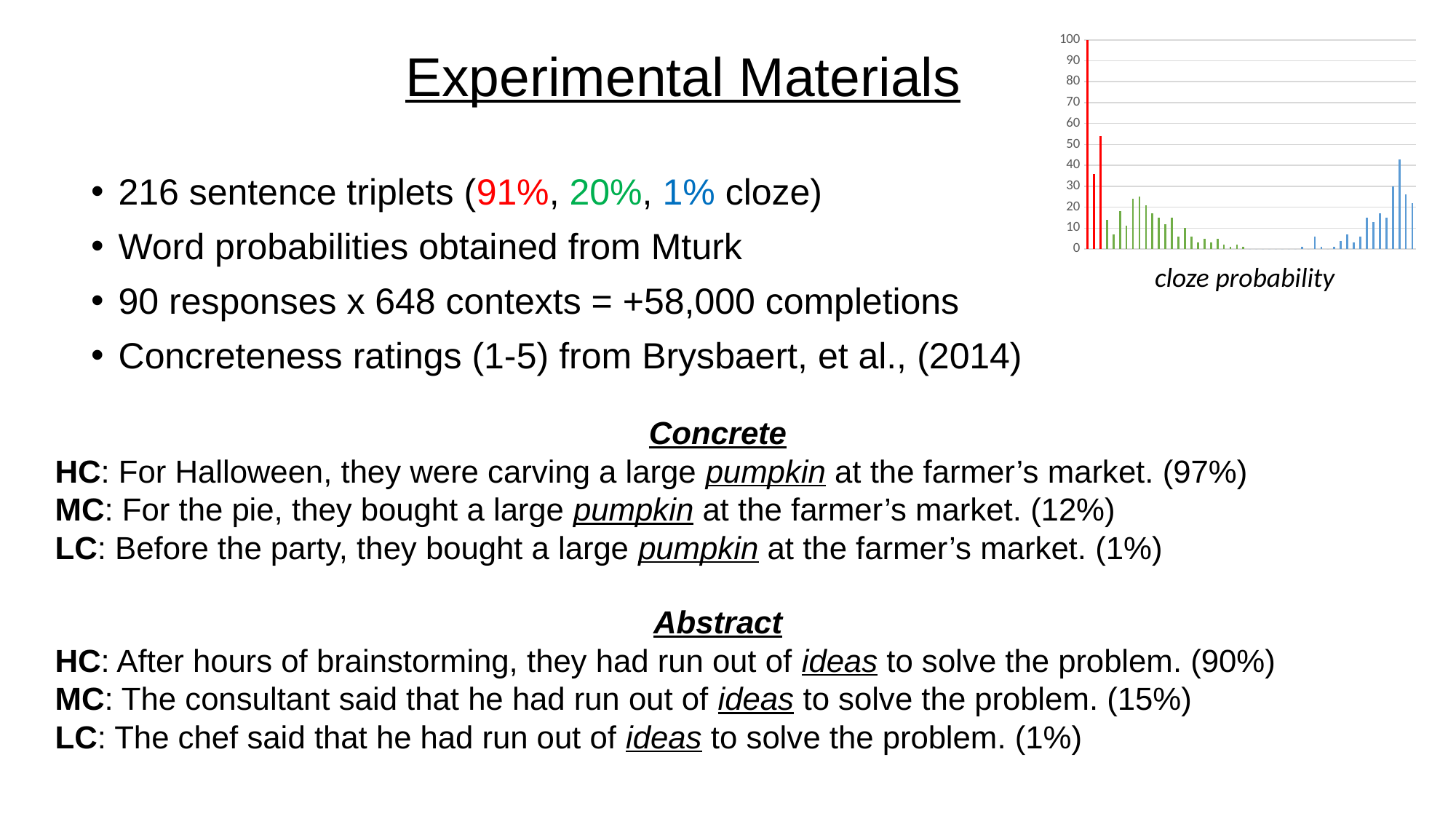
Is the tallest green bar in the chart greater or less than 10? greater Is the tallest blue bar in the chart greater or less than 60? less What kind of chart is shown in the top right of the slide? bar chart What is the highest value shown on the chart's y axis? 100 What is the label written beneath the chart's x axis? cloze probability Is the tallest red bar in the chart greater or less than 90? greater Is the tallest red bar taller or shorter than the tallest blue bar? taller Which colour of bars reaches the highest value in the chart: red, green or blue? red